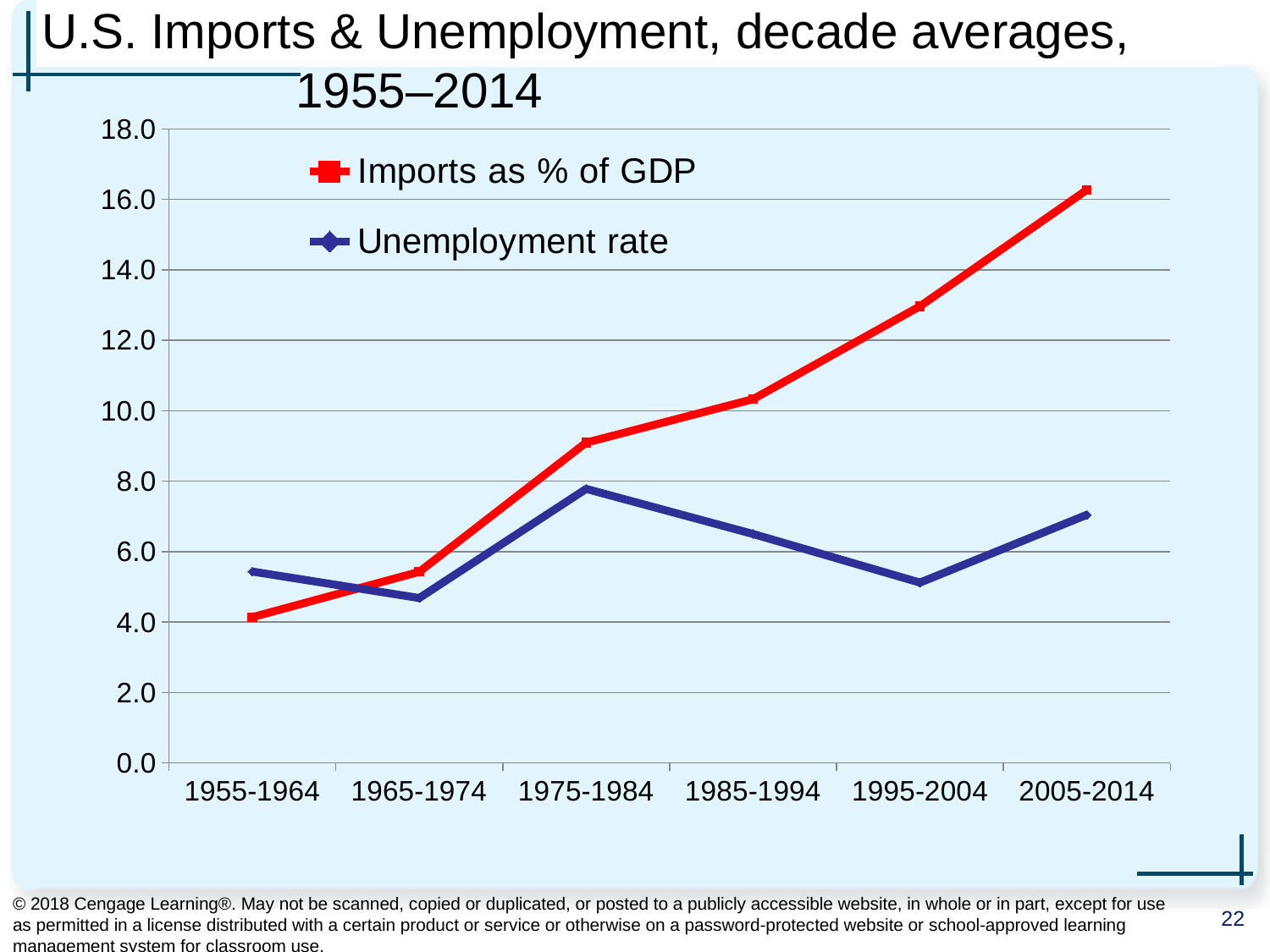
Is the value for Imports as % of GDP in 2005-2014 greater or less than 14.0? greater How many series does the legend list? 2 Does Imports as % of GDP rise or fall across the periods from 1955-1964 to 2005-2014? rise In which period is the Unemployment rate highest? 1975-1984 In which period is Imports as % of GDP highest? 2005-2014 In 1985-1994, which is higher: Imports as % of GDP or the Unemployment rate? Imports as % of GDP In which period is the Unemployment rate lowest? 1965-1974 Is the Unemployment rate in 1975-1984 greater or less than 6.0? greater What kind of chart is shown on the slide? line chart In 1955-1964, which is higher: Imports as % of GDP or the Unemployment rate? Unemployment rate In which period is Imports as % of GDP lowest? 1955-1964 How many decade periods are shown on the x axis? 6